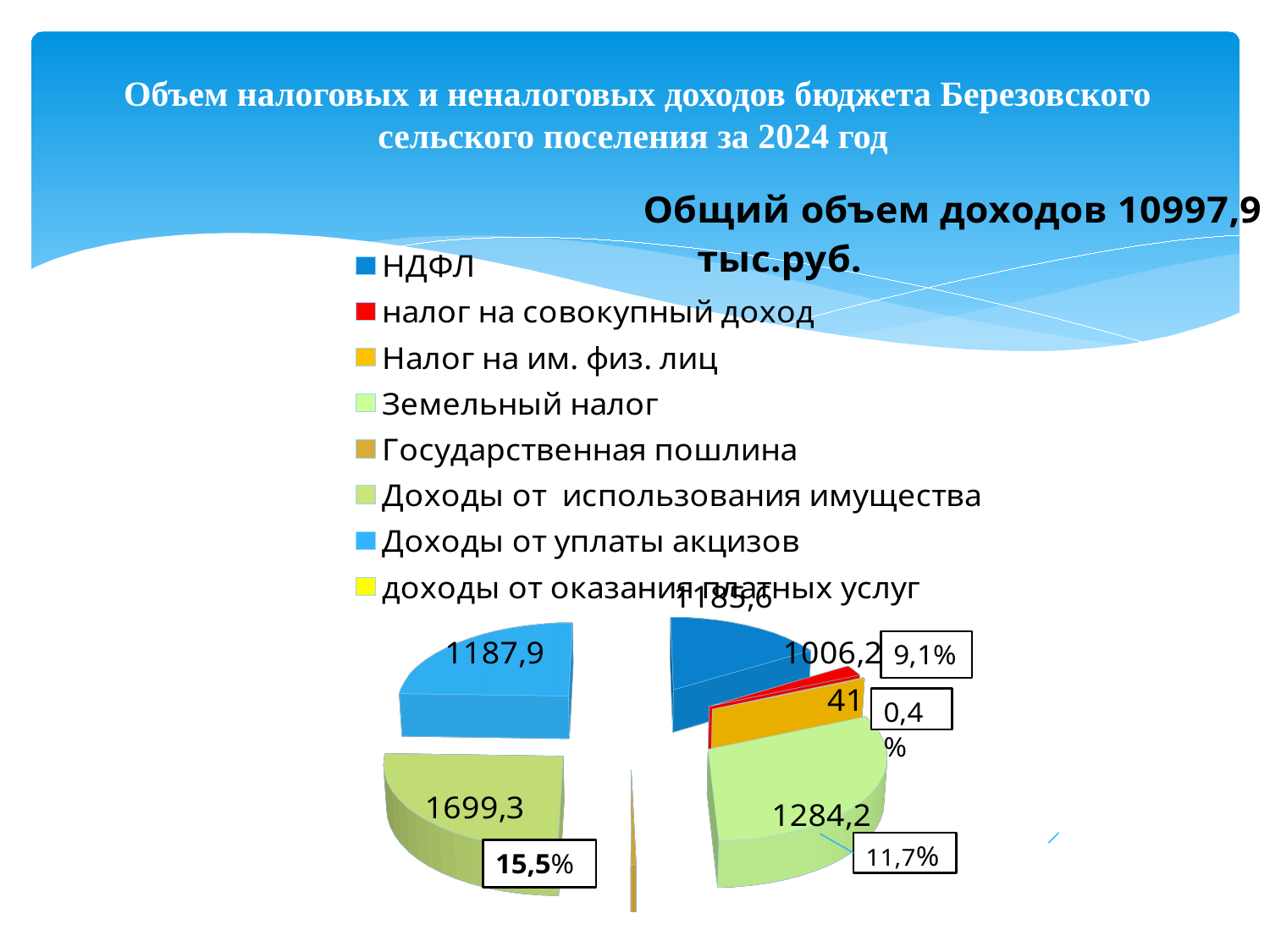
What value is shown for Доходы от использования имущества? 1699,3 What value is shown for Доходы от уплаты акцизов? 1187,9 What total income amount is stated on the slide? 10997,9 тыс.руб. What percentage share is shown next to the Доходы от использования имущества slice? 15,5% What is the difference between the values for Доходы от использования имущества (1699,3) and Земельный налог (1284,2)? 415,1 What kind of chart is shown on the slide? pie chart How many categories does the legend of the pie chart list? 8 Which is larger: Доходы от использования имущества or Земельный налог? Доходы от использования имущества What value is shown for Налог на им. физ. лиц? 41 What value is shown for Земельный налог? 1284,2 Which category has the largest labelled value in the pie chart? Доходы от использования имущества What percentage share is shown next to the Земельный налог slice? 11,7%